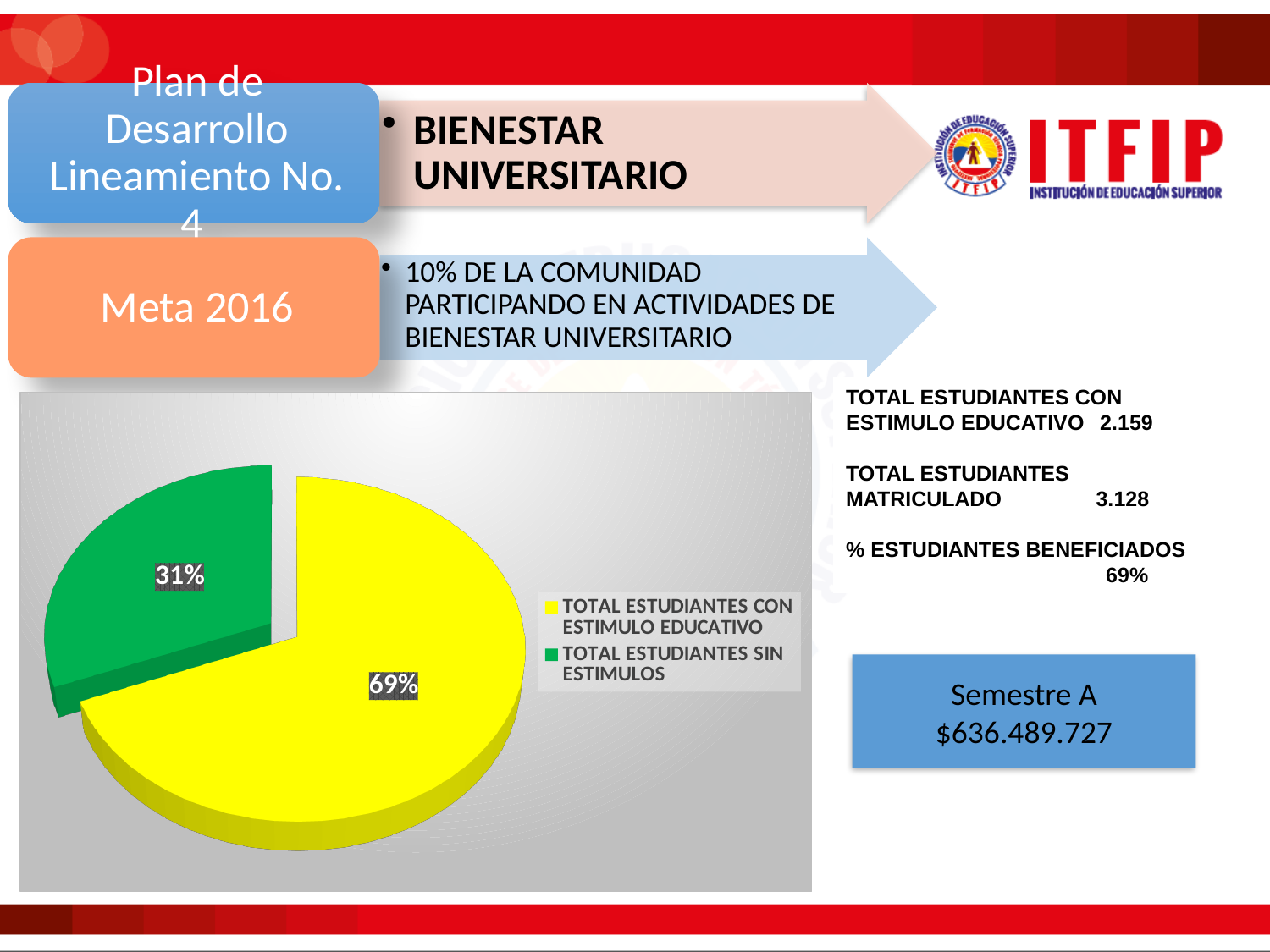
What share of the pie does TOTAL ESTUDIANTES CON ESTIMULO EDUCATIVO represent? 69% Which slice of the pie chart is the smallest? TOTAL ESTUDIANTES SIN ESTIMULOS What is the difference in percentage points between the two slices of the pie chart? 38 What kind of chart is shown on the slide? pie chart What share of the pie does TOTAL ESTUDIANTES SIN ESTIMULOS represent? 31% How many entries does the legend of the pie chart list? 2 Which is larger: the slice for TOTAL ESTUDIANTES CON ESTIMULO EDUCATIVO or the slice for TOTAL ESTUDIANTES SIN ESTIMULOS? TOTAL ESTUDIANTES CON ESTIMULO EDUCATIVO What colour is the slice for TOTAL ESTUDIANTES SIN ESTIMULOS? green What colour is the slice for TOTAL ESTUDIANTES CON ESTIMULO EDUCATIVO? yellow How many slices does the pie chart have? 2 Which slice of the pie chart is the largest? TOTAL ESTUDIANTES CON ESTIMULO EDUCATIVO